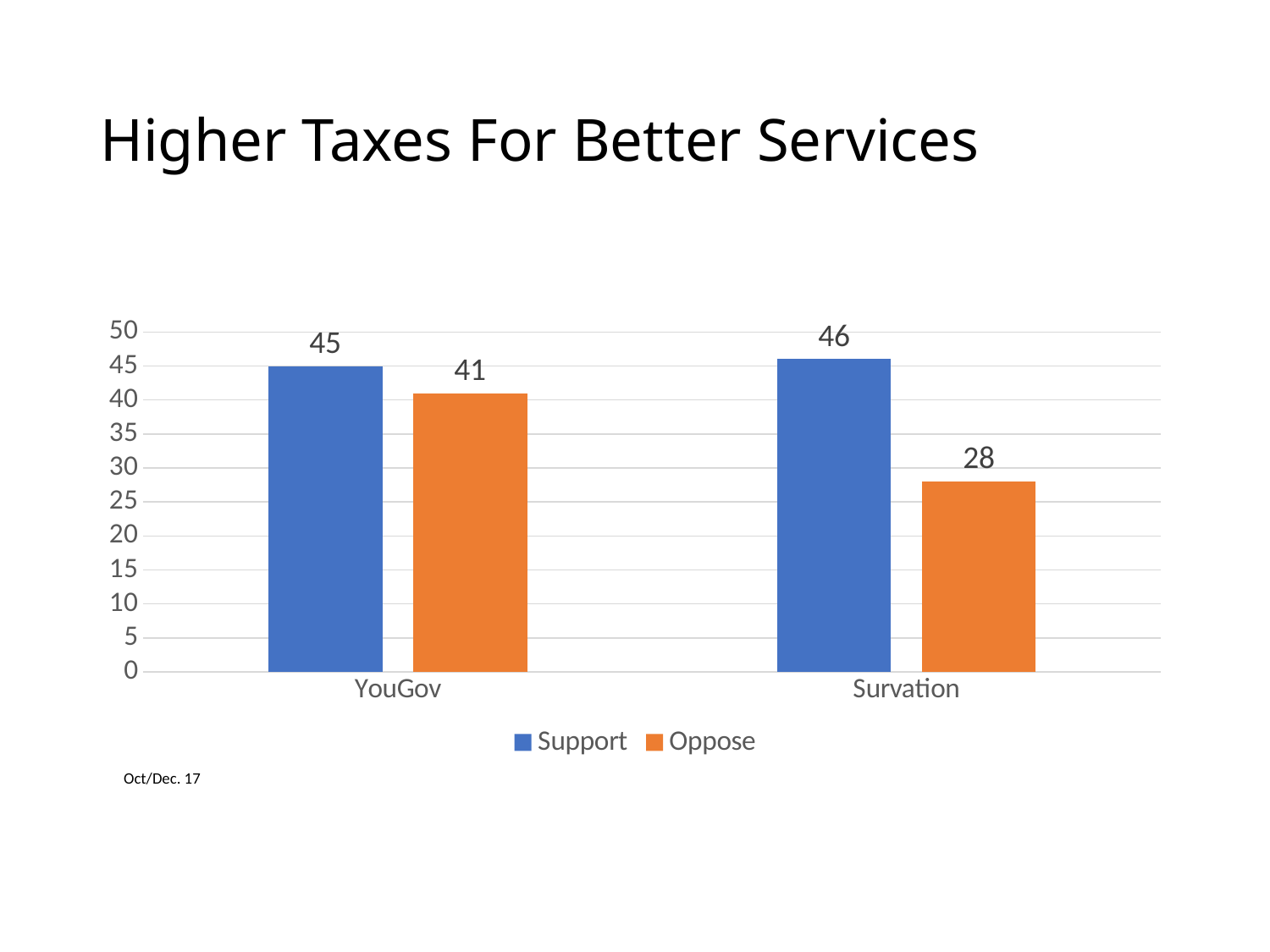
What is the difference between Support and Oppose for YouGov? 4 Is the Oppose value for Survation greater or less than 30? less What is the Oppose value for Survation? 28 How many pollsters are shown on the x axis? 2 What is the Oppose value for YouGov? 41 Which pollster has the lowest Oppose value? Survation Which is larger for YouGov, Support or Oppose? Support What kind of chart is shown on the slide? bar chart What is the difference between Support and Oppose for Survation? 18 What is the Support value for Survation? 46 How many series does the legend list? 2 What is the Support value for YouGov? 45